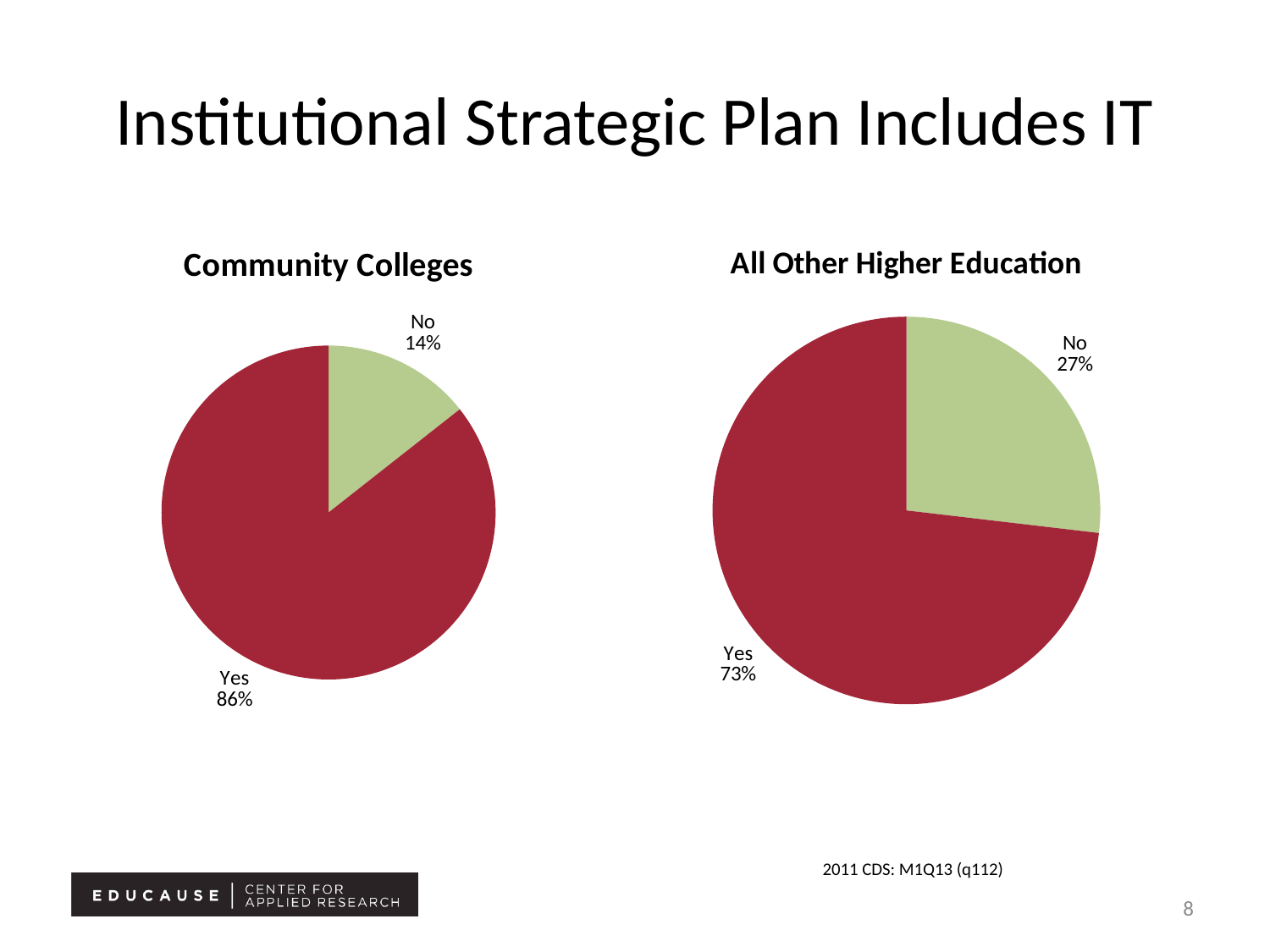
Which chart shows a larger Yes share, Community Colleges or All Other Higher Education? Community Colleges In the All Other Higher Education chart, what percentage answered Yes? 73% In the Community Colleges chart, what percentage answered No? 14% In the Community Colleges chart, what is the difference between the Yes and No percentages? 72% In the Community Colleges chart, which slice is the largest? Yes In the Community Colleges chart, what percentage answered Yes? 86% What is the title of the slide containing the two charts? Institutional Strategic Plan Includes IT What type of chart is the Community Colleges chart? Pie chart How many slices does the All Other Higher Education chart have? 2 In the All Other Higher Education chart, which slice is the smallest? No In the All Other Higher Education chart, what percentage answered No? 27% In the All Other Higher Education chart, what is the difference between the Yes and No percentages? 46%